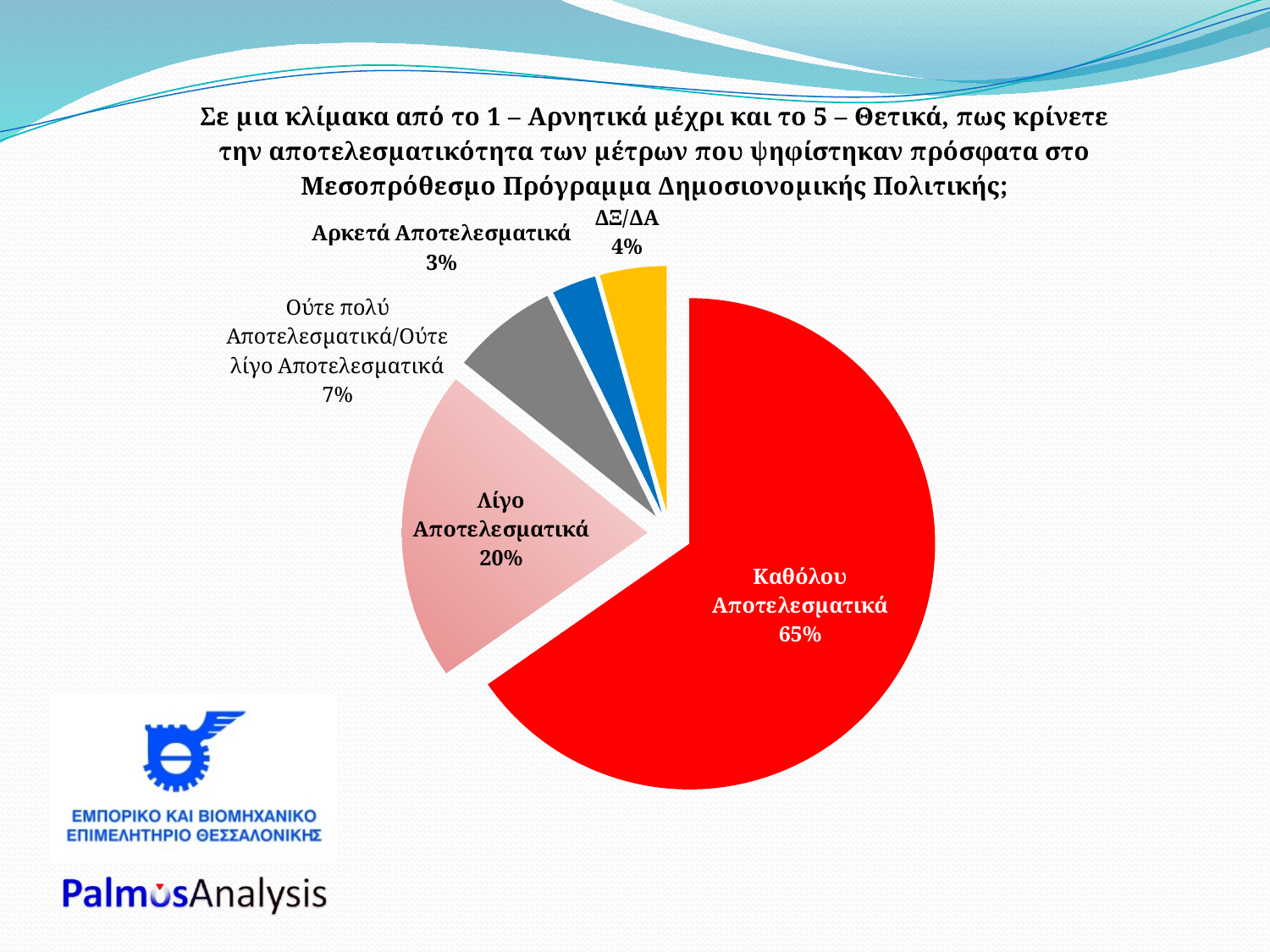
What kind of chart is shown on the slide? pie chart What percentage of respondents answered "Ούτε πολύ Αποτελεσματικά/Ούτε λίγο Αποτελεσματικά"? 7% How many categories (slices) does the pie chart have? 5 Which category has the smallest share of the pie? Αρκετά Αποτελεσματικά What percentage of respondents answered "Καθόλου Αποτελεσματικά"? 65% What is the difference in percentage points between "Καθόλου Αποτελεσματικά" and "Λίγο Αποτελεσματικά"? 45 Which is larger: the share for "ΔΞ/ΔΑ" or the share for "Αρκετά Αποτελεσματικά"? ΔΞ/ΔΑ Which category has the largest share of the pie? Καθόλου Αποτελεσματικά What percentage of respondents answered "ΔΞ/ΔΑ"? 4% What percentage of respondents answered "Αρκετά Αποτελεσματικά"? 3% What percentage of respondents answered "Λίγο Αποτελεσματικά"? 20% What colour is the slice for "Καθόλου Αποτελεσματικά"? red